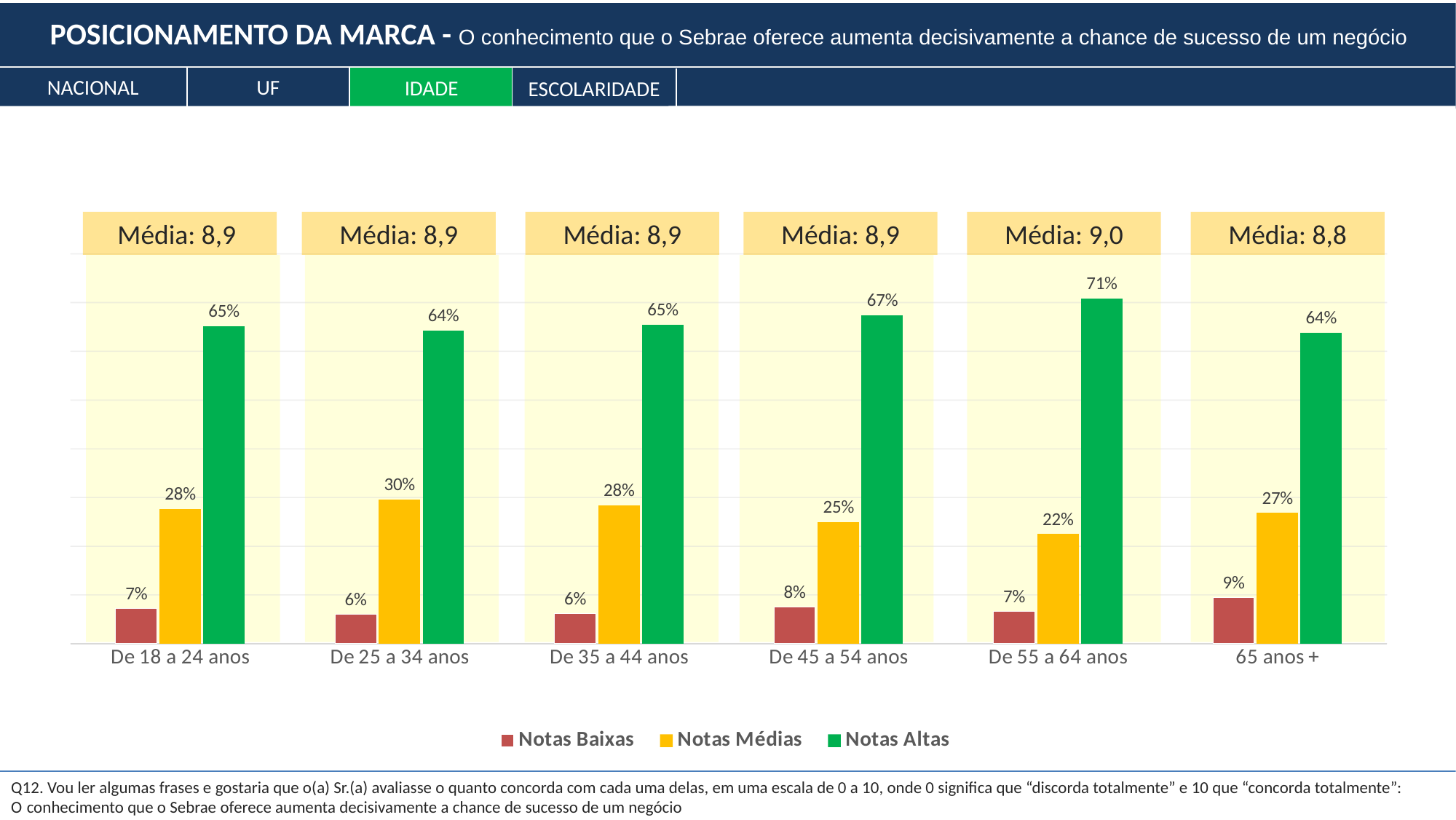
What is the difference between Notas Altas and Notas Médias for De 45 a 54 anos? 42 percentage points How many series does the legend list? 3 What is the value of Notas Médias for De 25 a 34 anos? 30% Which age group has the highest Notas Altas value? De 55 a 64 anos What is the value of Notas Altas for De 55 a 64 anos? 71% Which colour represents Notas Altas in the legend? Green What kind of chart is shown on the slide? Bar chart What is the value of Notas Baixas for 65 anos +? 9% What is the Média shown for De 55 a 64 anos? 9,0 How many age groups are shown on the x axis? 6 Which age group has the lowest Notas Médias value? De 55 a 64 anos Which is larger for De 35 a 44 anos: Notas Médias or Notas Baixas? Notas Médias